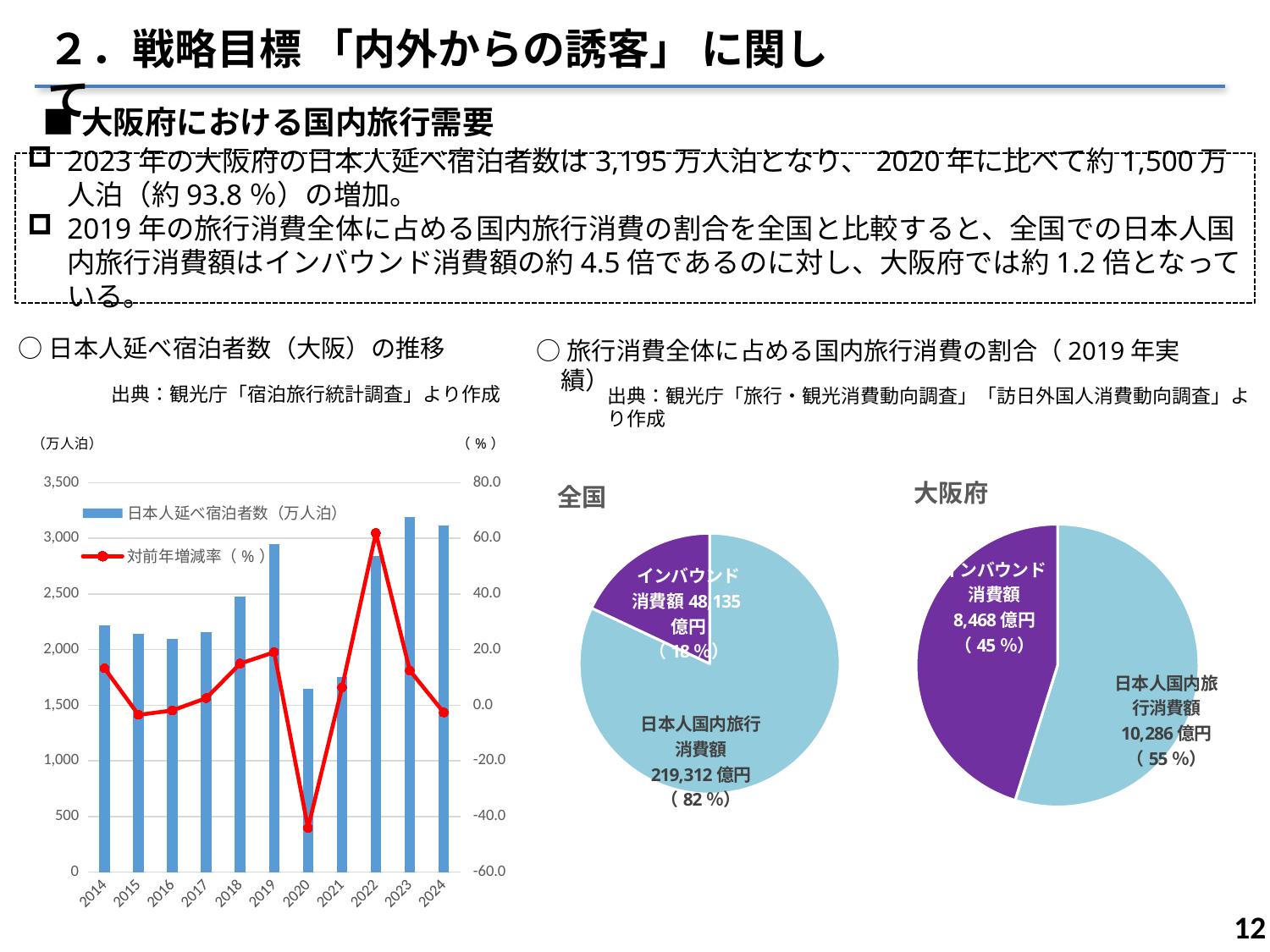
In the 大阪府 pie chart, which is larger, 日本人国内旅行消費額 or インバウンド消費額? 日本人国内旅行消費額 In the 大阪府 pie chart, what is the difference between 日本人国内旅行消費額 and インバウンド消費額? 1,818億円 In the left chart (日本人延べ宿泊者数（大阪）の推移), which year has the highest bar for 日本人延べ宿泊者数? 2023 In the left chart (日本人延べ宿泊者数（大阪）の推移), how many years are shown on the x axis? 11 In the left chart (日本人延べ宿泊者数（大阪）の推移), in which year does the 対前年増減率 line reach its lowest point? 2020 In the 大阪府 pie chart, what is the value of インバウンド消費額? 8,468億円 In the left chart (日本人延べ宿泊者数（大阪）の推移), is the 対前年増減率 value for 2022 greater or less than 40.0? greater In the 全国 pie chart, what is the value of 日本人国内旅行消費額? 219,312億円 In the left chart (日本人延べ宿泊者数（大阪）の推移), how many series does the legend list? 2 In the left chart (日本人延べ宿泊者数（大阪）の推移), is the bar value for 2020 greater or less than 2,000? less In the left chart (日本人延べ宿泊者数（大阪）の推移), which year has the lowest bar for 日本人延べ宿泊者数? 2020 In the 全国 pie chart, what share does インバウンド消費額 have? 18%